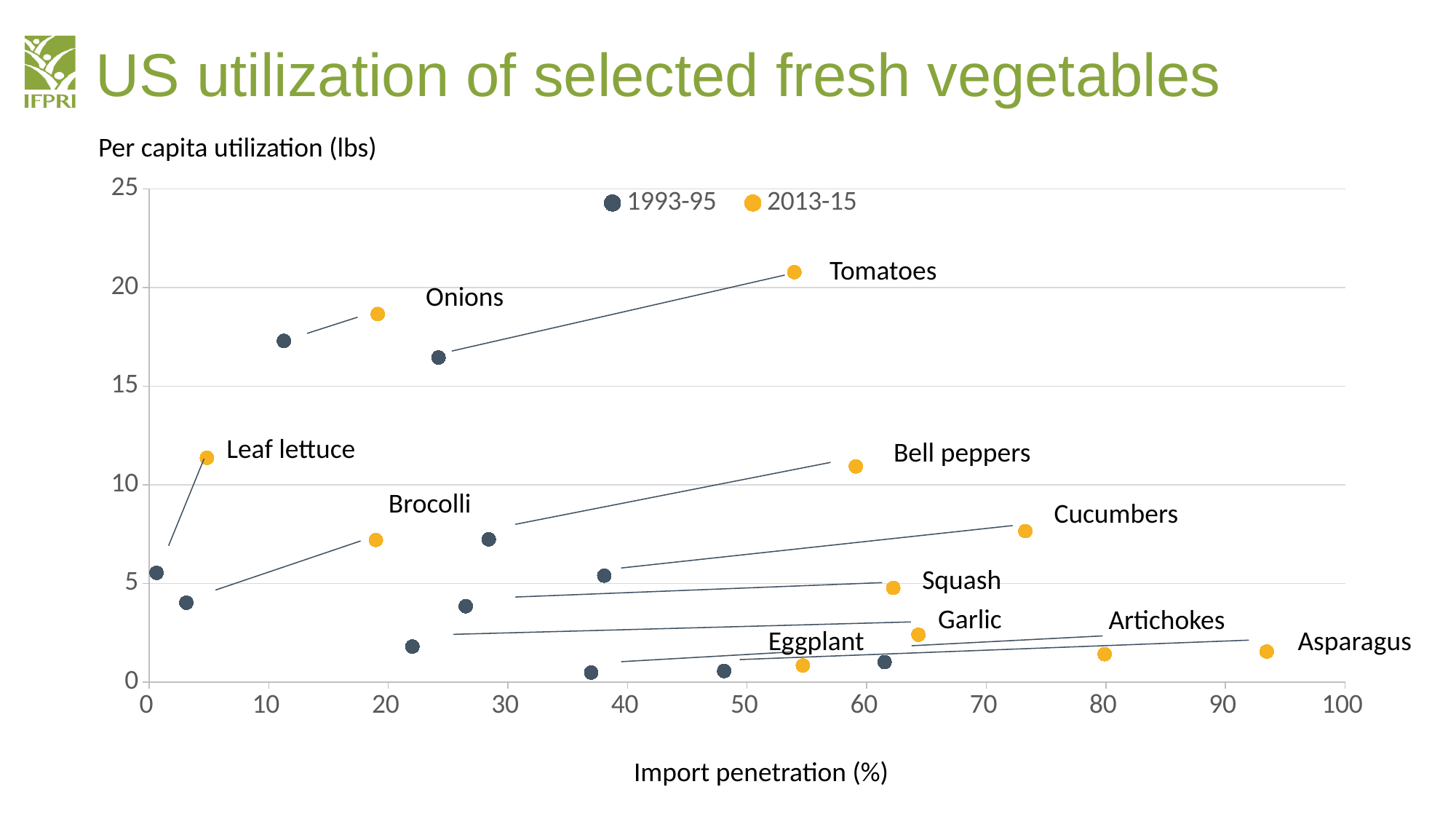
How many series does the legend list? 2 Which vegetable has the highest import penetration in 2013-15? Asparagus Which vegetable has the lowest per capita utilization in 2013-15? Eggplant Which vegetable has the highest per capita utilization in 2013-15? Tomatoes What is the label of the horizontal axis? Import penetration (%) How many vegetables are labeled on the chart? 11 Is the 2013-15 per capita utilization for Tomatoes greater or less than 15 lbs? greater Is the 2013-15 import penetration for Asparagus greater or less than 90%? greater What kind of chart is shown on the slide? scatter chart What are the two series named in the legend? 1993-95 and 2013-15 In 2013-15, which has the higher per capita utilization, Onions or Tomatoes? Tomatoes Is the 2013-15 import penetration for Leaf lettuce greater or less than 10%? less